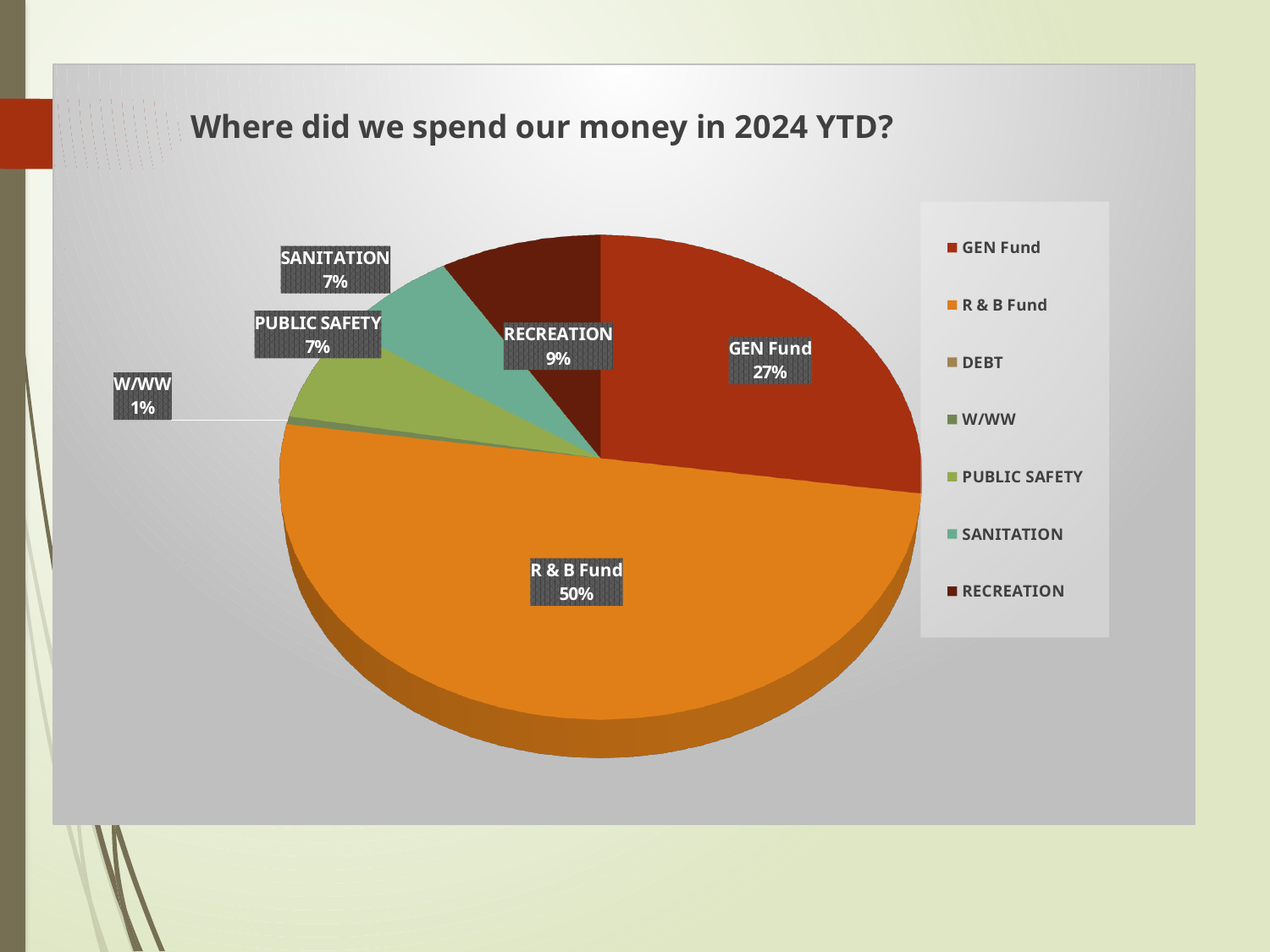
How many entries does the legend list? 7 What percentage is shown for GEN Fund? 27% What is the difference in percentage points between R & B Fund and GEN Fund? 23 What percentage is shown for PUBLIC SAFETY? 7% Which category has the largest slice of the pie? R & B Fund What share of spending does the R & B Fund slice represent? 50% What percentage is shown for RECREATION? 9% Which is larger, the RECREATION slice or the SANITATION slice? RECREATION What percentage is shown for W/WW? 1% Which labeled slice has the smallest percentage? W/WW What is the title of the chart? Where did we spend our money in 2024 YTD? What kind of chart is shown on the slide? pie chart